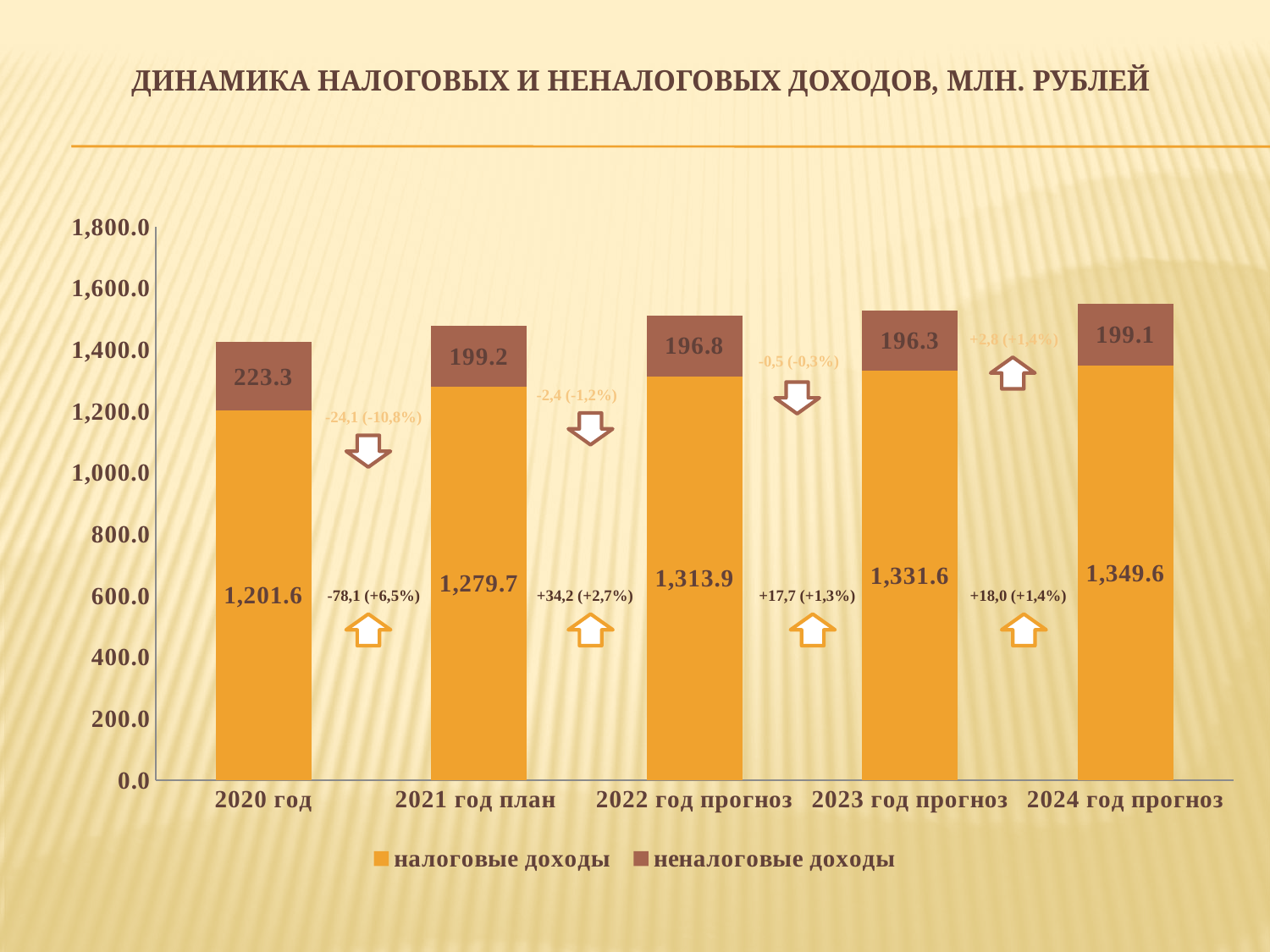
What is the total of the stacked bar for 2020 год? 1,424.9 How many categories are shown on the x axis? 5 What is the value of налоговые доходы for 2020 год? 1,201.6 Which is larger: неналоговые доходы for 2021 год план or for 2022 год прогноз? 2021 год план What is the total of the stacked bar for 2024 год прогноз? 1,548.7 Do the values of налоговые доходы rise or fall from 2020 год to 2024 год прогноз? rise Which category has the lowest value of налоговые доходы? 2020 год What is the difference between налоговые доходы for 2024 год прогноз and 2023 год прогноз? 18.0 What is the value of неналоговые доходы for 2024 год прогноз? 199.1 How many series does the legend list? 2 Which category has the highest value of неналоговые доходы? 2020 год What is the value of налоговые доходы for 2022 год прогноз? 1,313.9